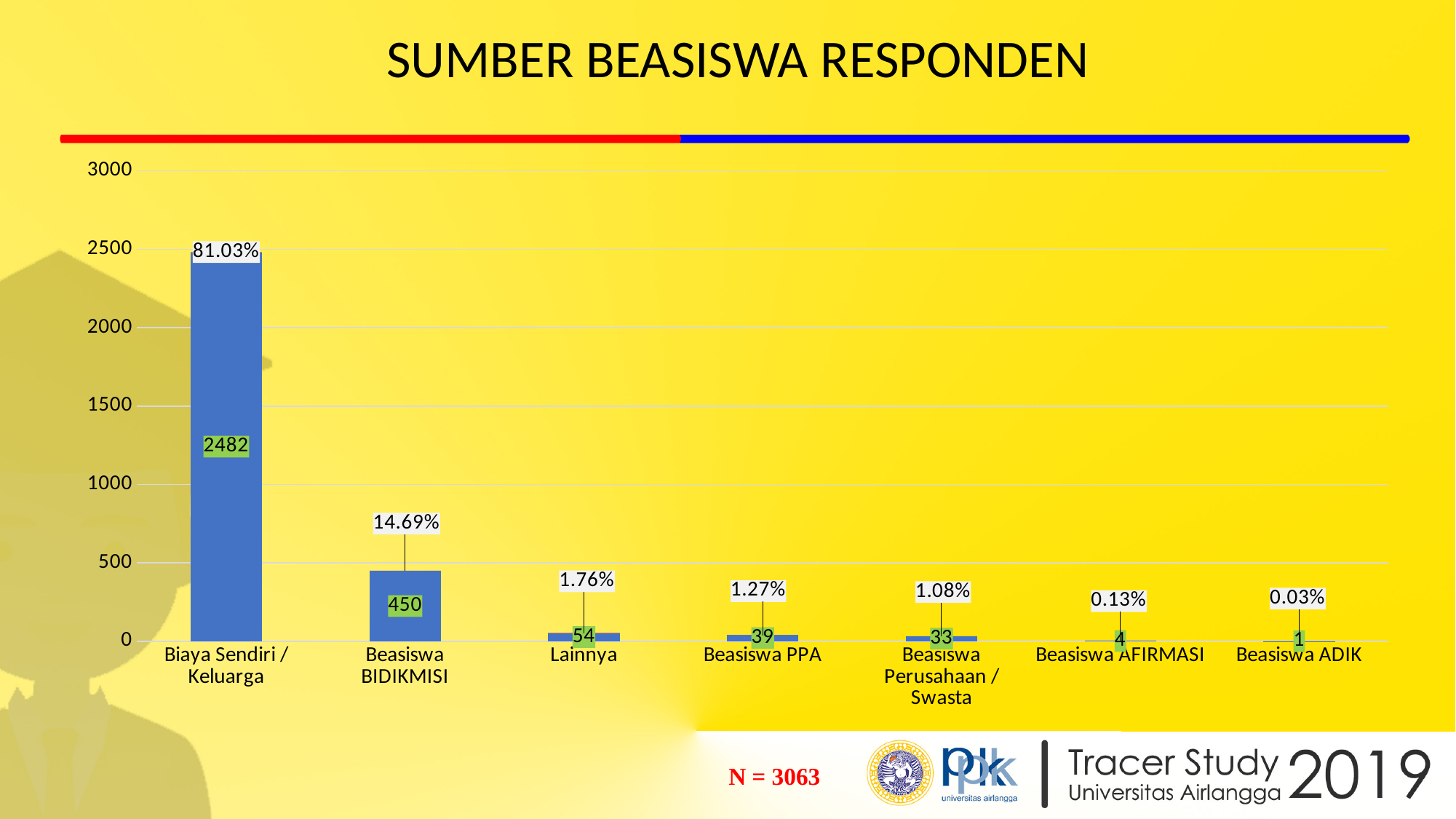
What is the title of the chart? SUMBER BEASISWA RESPONDEN How many categories are shown on the x axis? 7 Which is larger, the value for Beasiswa PPA or Beasiswa Perusahaan / Swasta? Beasiswa PPA What percentage is shown for Beasiswa AFIRMASI? 0.13% Which category has the highest value? Biaya Sendiri / Keluarga What is the value for Biaya Sendiri / Keluarga? 2482 What percentage is shown for Lainnya? 1.76% What is the value for Beasiswa PPA? 39 What is the value for Beasiswa BIDIKMISI? 450 What is the difference between the values for Biaya Sendiri / Keluarga and Beasiswa BIDIKMISI? 2032 What kind of chart is shown on the slide? Bar chart Which category has the lowest value? Beasiswa ADIK